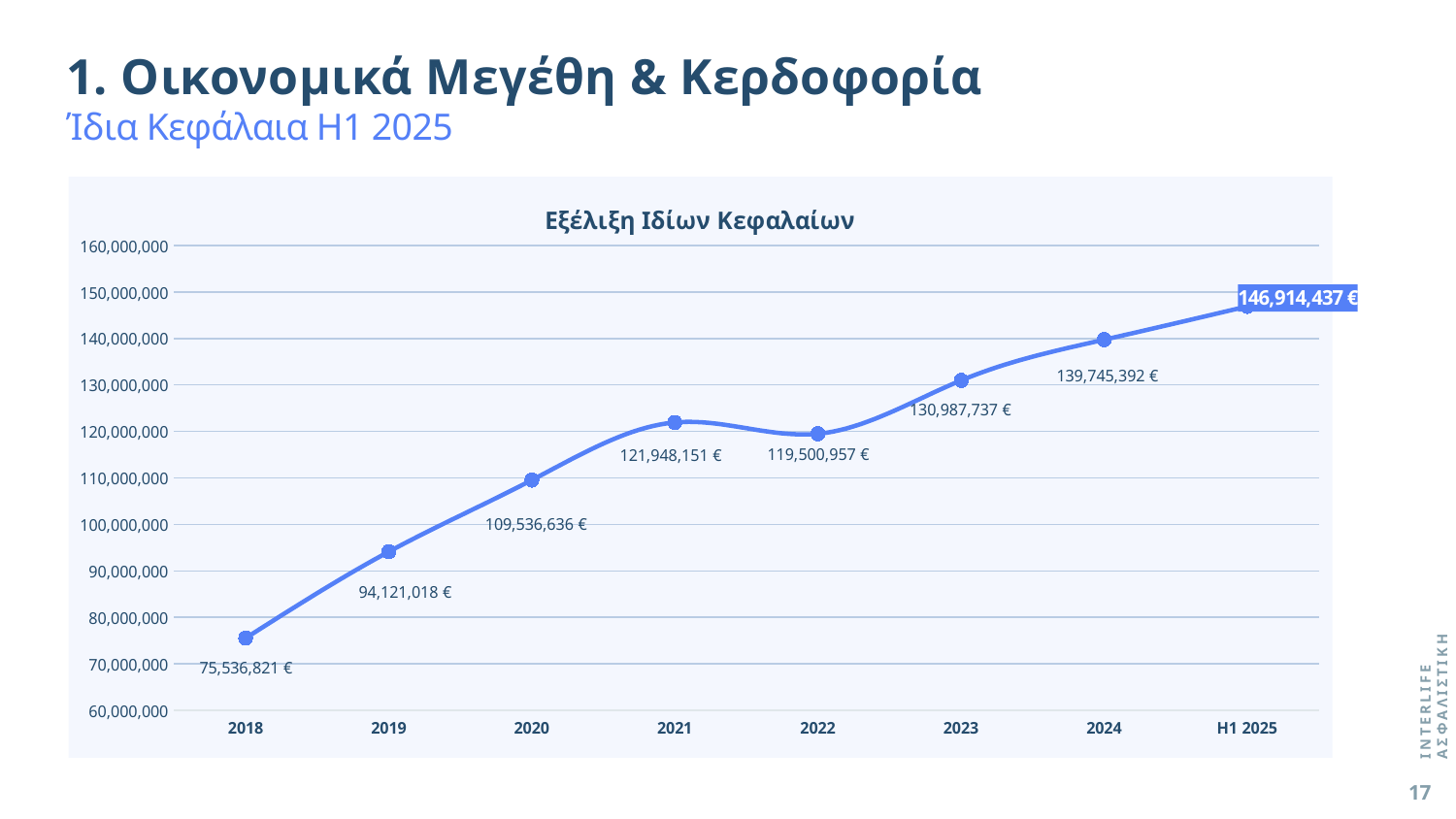
Which year has the lowest value in the chart? 2018 What kind of chart is shown on the slide? Line chart Which is larger, the value for 2021 or the value for 2022? 2021 How many data points are plotted in the chart? 8 What is the title of the chart? Εξέλιξη Ιδίων Κεφαλαίων What is the difference between the values for 2021 and 2022? 2,447,194 € What is the value for 2022 in the chart? 119,500,957 € What is the value for H1 2025 in the chart? 146,914,437 € Is the value for 2020 greater or less than 100,000,000? greater What is the difference between the values for H1 2025 and 2024? 7,169,045 € Which period has the highest value in the chart? H1 2025 What is the value for 2018 in the chart? 75,536,821 €